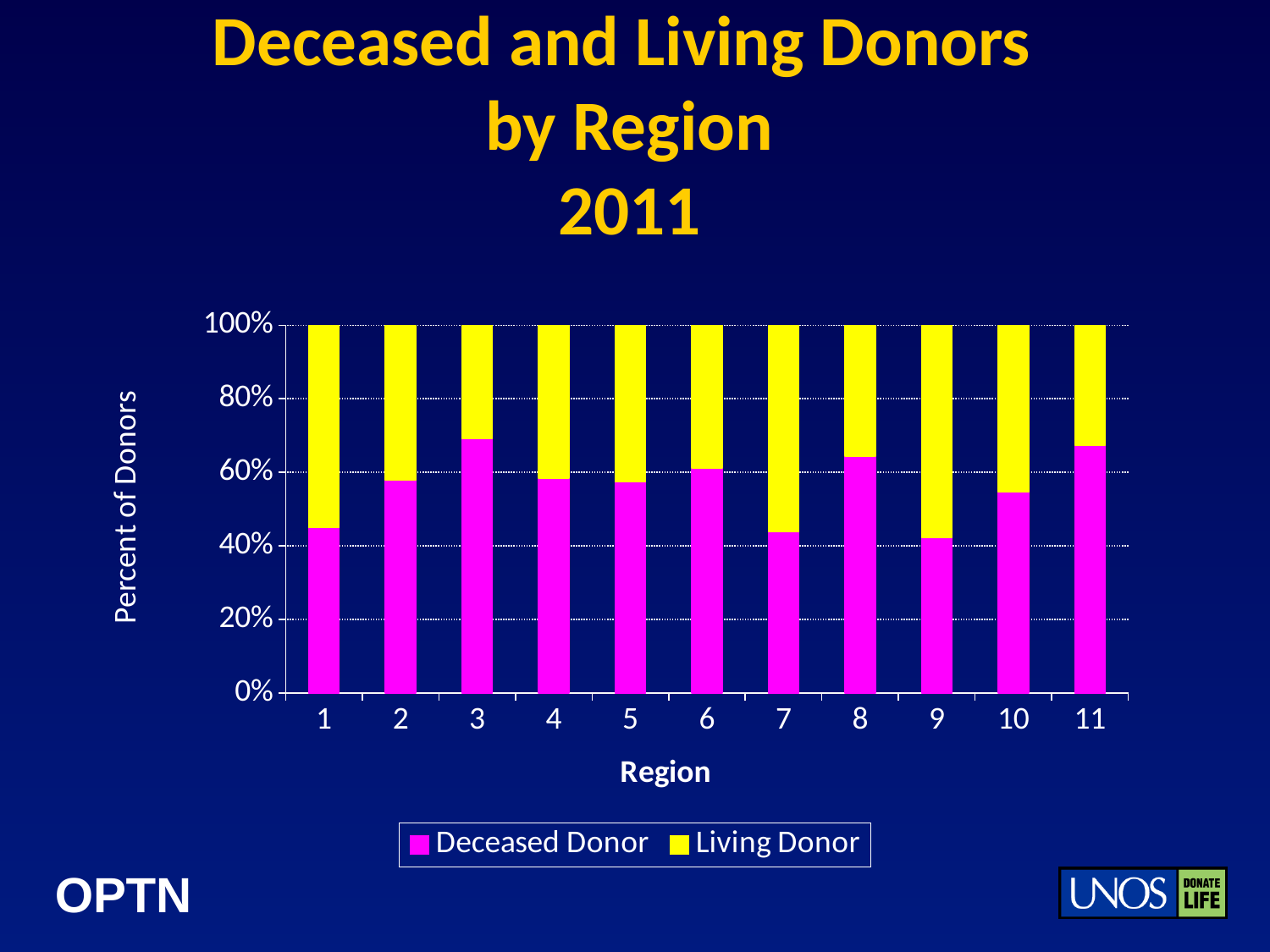
How many regions are shown on the x axis of the chart? 11 What is the title of the chart on the slide? Deceased and Living Donors by Region 2011 Is the Deceased Donor value for Region 9 greater or less than 60%? less Is the Deceased Donor value for Region 3 greater or less than 60%? greater Which region has the larger Deceased Donor share, Region 3 or Region 1? Region 3 Which region has the larger Living Donor share, Region 7 or Region 8? Region 7 Is the Deceased Donor value for Region 11 greater or less than 60%? greater Which colour represents Living Donor in the chart's legend? Yellow How many series does the chart's legend list? 2 What kind of chart is shown on the slide? Stacked bar chart What is the total height of the stacked bar for Region 5? 100%